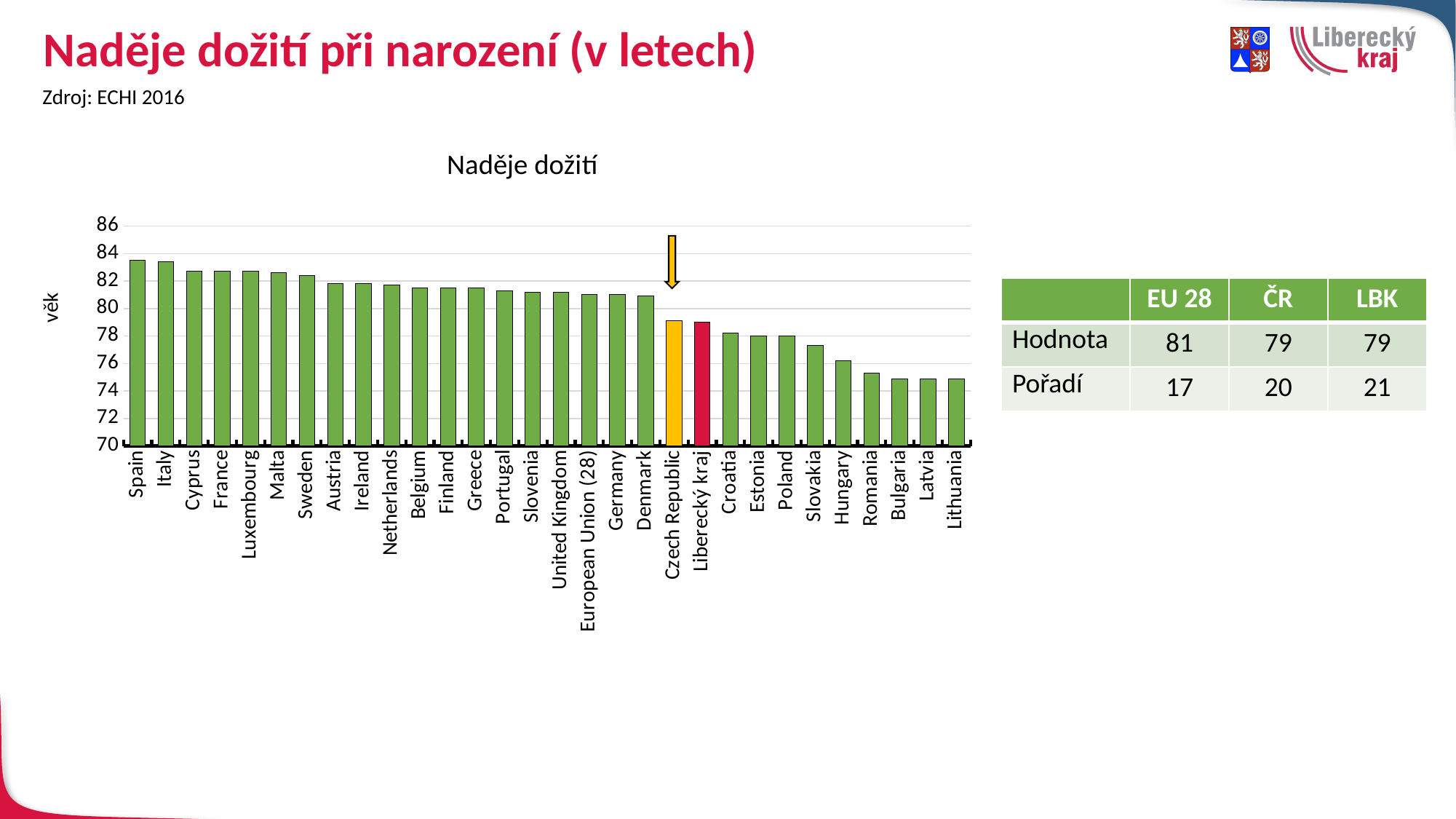
Is the value for Hungary greater or less than 78? less Is the value for Germany greater or less than 80? greater Is the value for Czech Republic greater or less than 80? less Do the values in the chart rise or fall from left to right along the x axis? fall What kind of chart is shown on the slide? bar chart How many countries/regions are plotted in the chart? 30 Which has the higher value, Sweden or Hungary? Sweden What is the title of the chart? Naděje dožití What is the label on the vertical axis of the chart? věk Which has the higher value, Austria or Poland? Austria